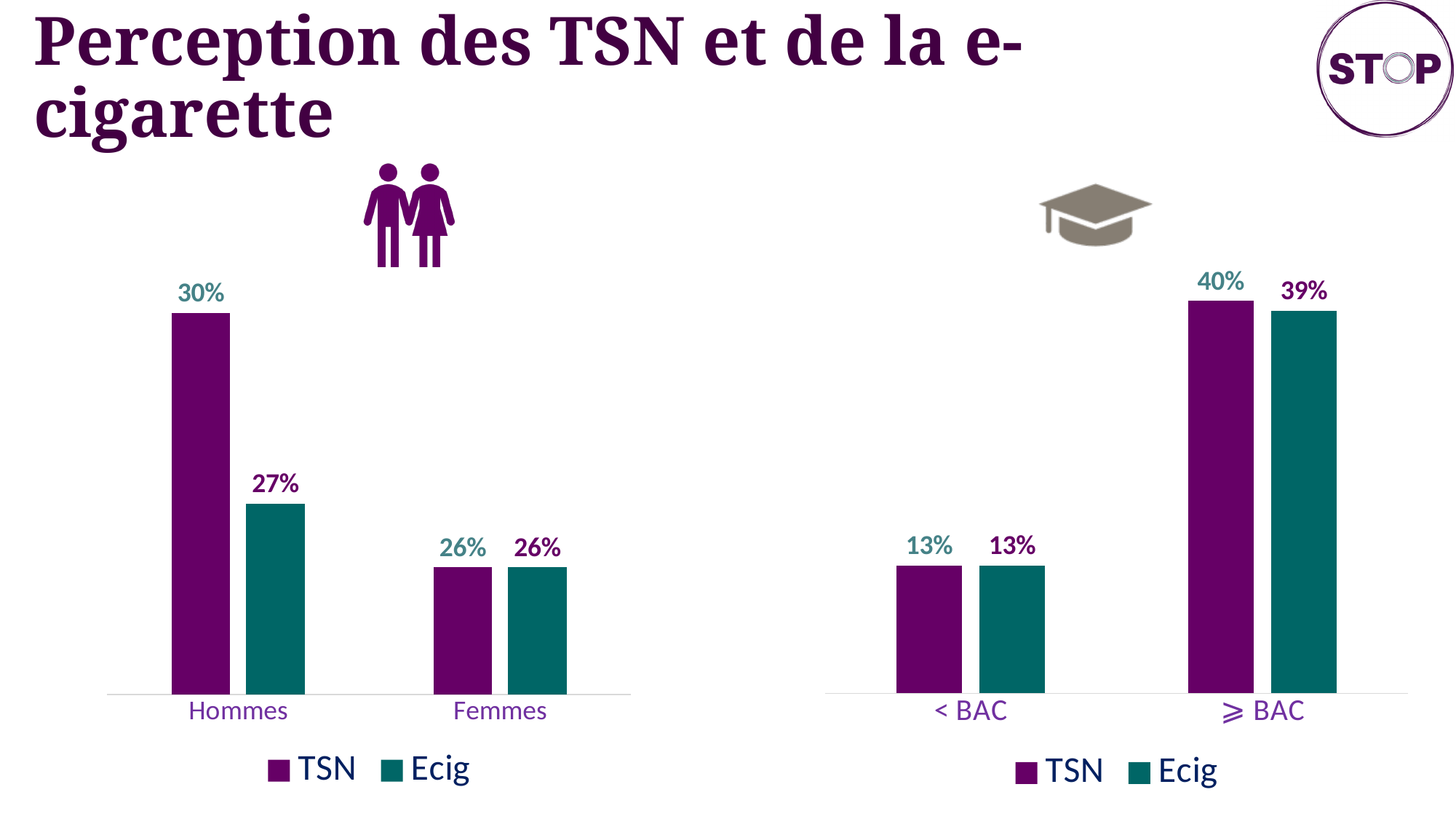
In the left chart (Hommes/Femmes), what is the TSN value for Hommes? 30% In the right chart (< BAC / ≥ BAC), what is the difference between the TSN values for ≥ BAC and < BAC? 27% In the left chart (Hommes/Femmes), what is the Ecig value for Femmes? 26% In the right chart (< BAC / ≥ BAC), which category has the highest Ecig value? ≥ BAC What type of chart is the left chart (Hommes/Femmes)? bar chart In the left chart (Hommes/Femmes), what is the difference between the TSN and Ecig values for Hommes? 3% In the right chart (< BAC / ≥ BAC), what is the Ecig value for < BAC? 13% How many series does the legend of the right chart (< BAC / ≥ BAC) list? 2 In the left chart (Hommes/Femmes), what is the Ecig value for Hommes? 27% In the left chart (Hommes/Femmes), which category has the lowest TSN value? Femmes In the left chart (Hommes/Femmes), is the TSN value for Hommes larger or smaller than the TSN value for Femmes? larger In the right chart (< BAC / ≥ BAC), what is the TSN value for ≥ BAC? 40%